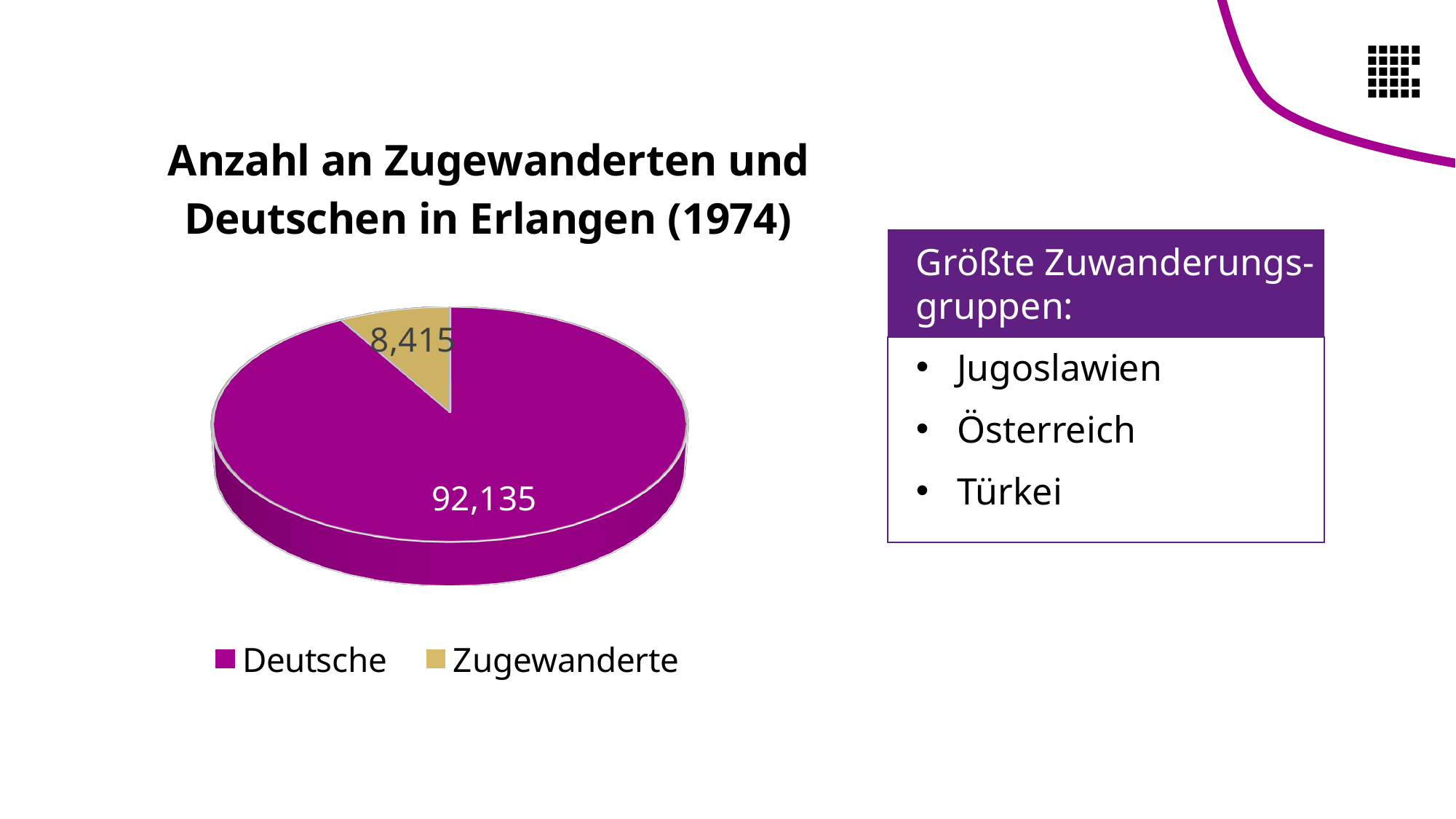
Which is larger, the value for Deutsche or the value for Zugewanderte? Deutsche What colour is the Zugewanderte slice in the pie chart? gold Which category has the smallest slice in the pie chart? Zugewanderte How many slices does the pie chart have? 2 How many entries does the legend list? 2 What kind of chart is shown on the slide? pie chart What is the value for Deutsche in the pie chart? 92,135 What is the title of the chart? Anzahl an Zugewanderten und Deutschen in Erlangen (1974) What is the value for Zugewanderte in the pie chart? 8,415 What is the difference between the values for Deutsche and Zugewanderte? 83,720 What is the total of the two values shown in the pie chart? 100,550 Which category has the largest slice in the pie chart? Deutsche